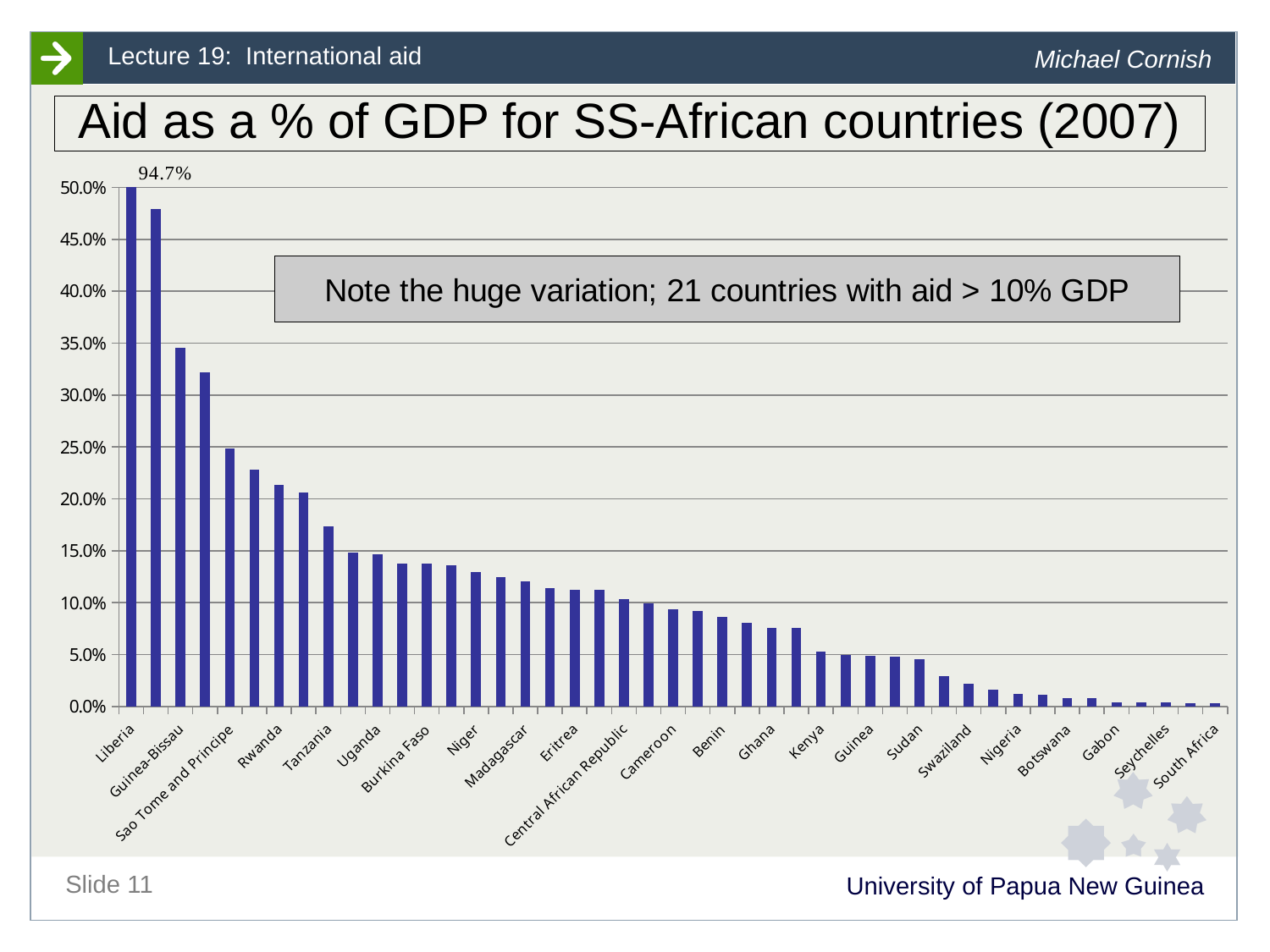
Is the value for Sao Tome and Principe greater or less than 30%? less Which country has the highest aid as a % of GDP? Liberia According to the note on the slide, how many countries have aid greater than 10% of GDP? 21 What kind of chart is shown on the slide? bar chart Which has the larger value, Rwanda or Tanzania? Rwanda Is the value for Kenya greater or less than 10%? less Is the value for Tanzania greater or less than 20%? less What is the aid as a % of GDP value labelled for Liberia? 94.7% Do the values rise or fall moving from left to right along the x axis? fall What is the title of the chart? Aid as a % of GDP for SS-African countries (2007)